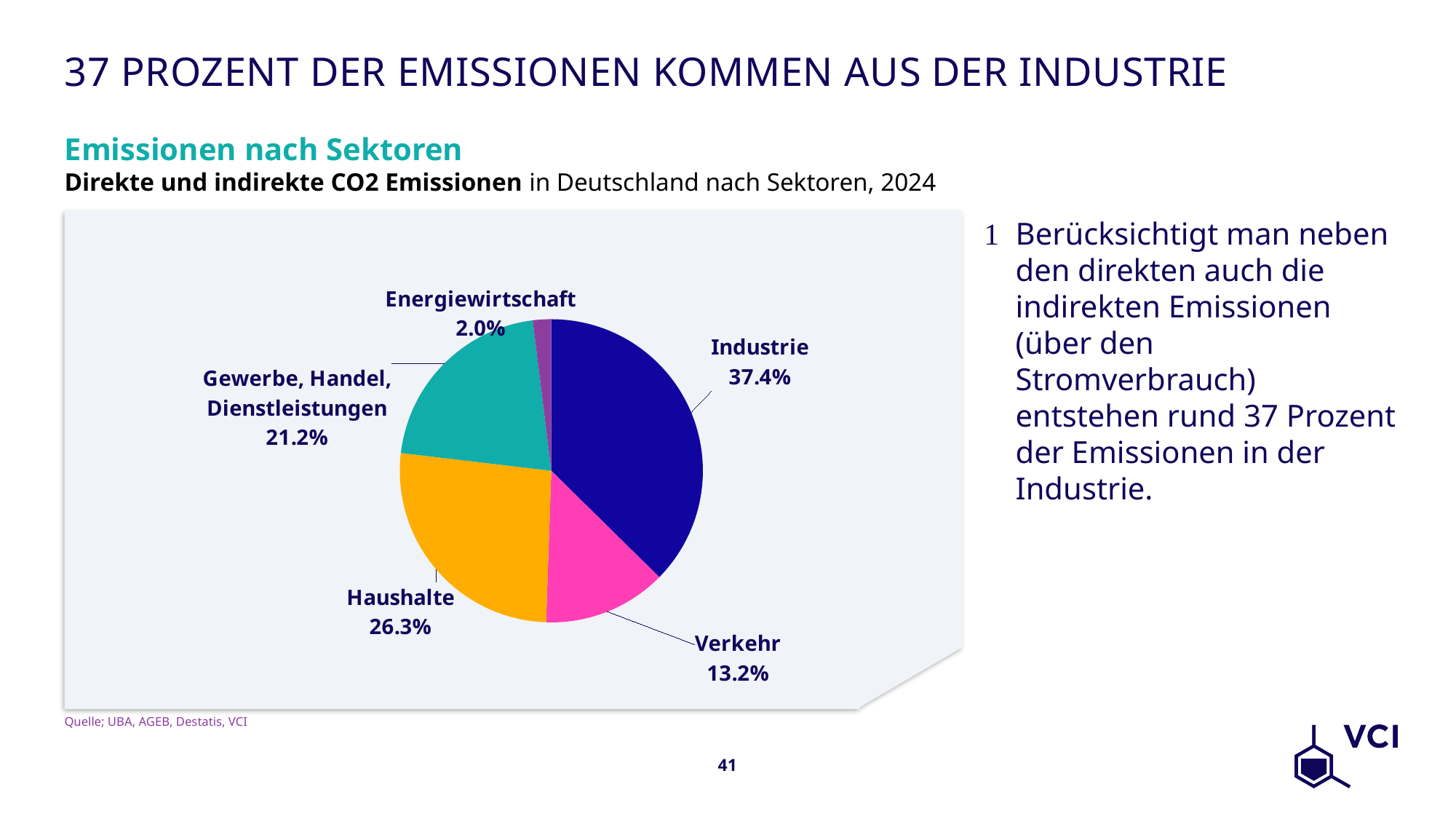
Which has a larger share, Verkehr or Gewerbe, Handel, Dienstleistungen? Gewerbe, Handel, Dienstleistungen How many sectors are shown in the pie chart? 5 Which sector has the smallest share of emissions? Energiewirtschaft What share of emissions does the Gewerbe, Handel, Dienstleistungen slice represent? 21.2% What share of emissions does the Verkehr slice represent? 13.2% What kind of chart is shown on the slide? Pie chart What share of emissions does the Industrie slice represent? 37.4% What is the difference in percentage points between the Industrie and Haushalte shares? 11.1 What is the title of the chart? Emissionen nach Sektoren Which sector has the largest share of emissions? Industrie What share of emissions does the Energiewirtschaft slice represent? 2.0% What share of emissions does the Haushalte slice represent? 26.3%